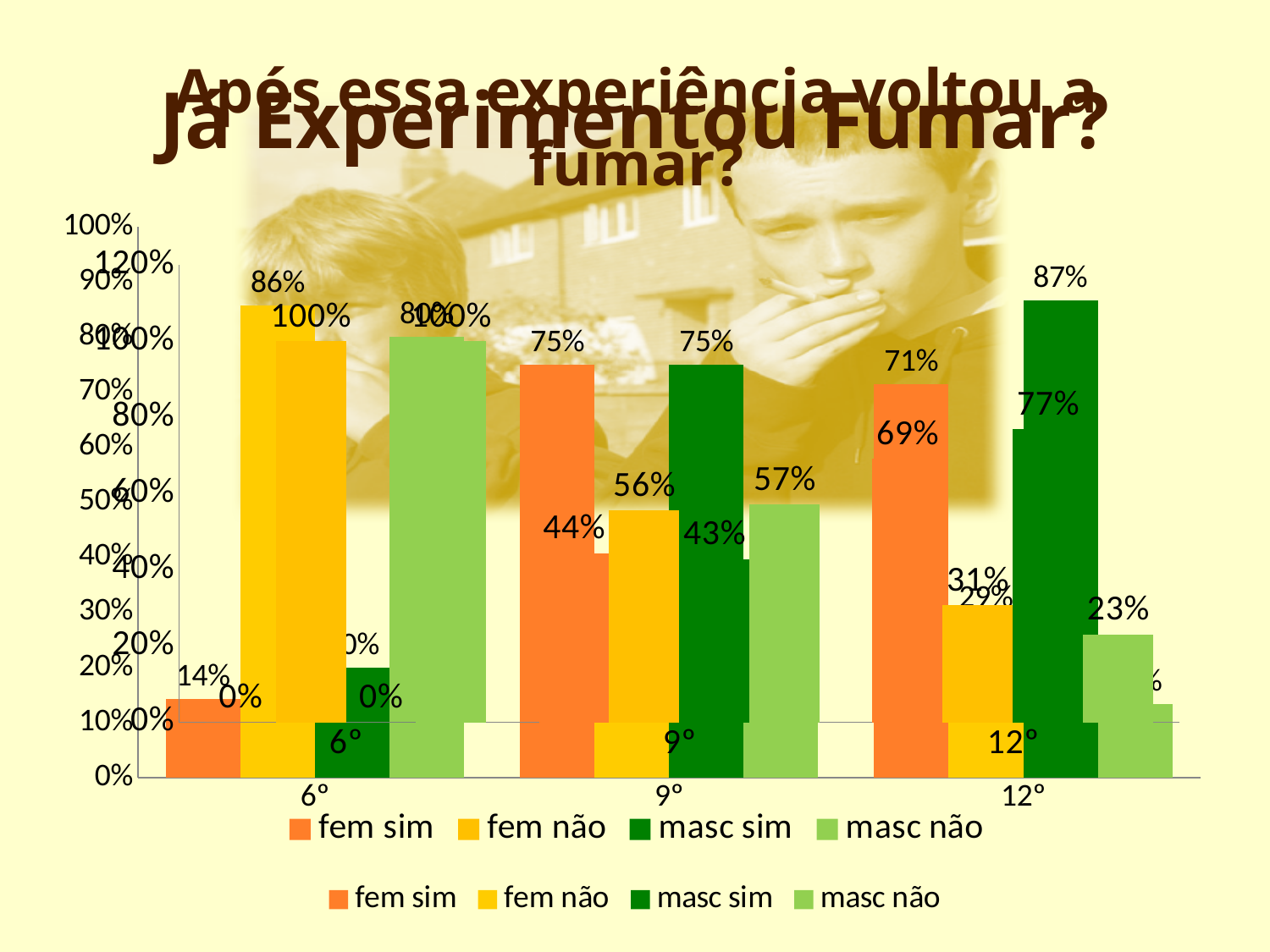
In the chart whose y axis runs from 0% to 100% in 10% steps, what is the value for masc sim at 12°? 87% In the chart whose y axis runs from 0% to 100% in 10% steps, what is the value for fem sim at 12°? 71% In the chart whose y axis runs from 0% to 100% in 10% steps, what is the value for fem sim at 6°? 14% How many series does the legend list? 4 What are the series names listed in the legend? fem sim, fem não, masc sim, masc não In the chart whose y axis runs from 0% to 100% in 10% steps, what is the value for fem não at 6°? 86% In the chart whose y axis runs from 0% to 100% in 10% steps, which series has the highest value at 12°? masc sim In the chart whose y axis runs from 0% to 100% in 10% steps, what is the difference between fem não (86%) and fem sim (14%) at 6°? 72% How many categories are shown on the x axis? 3 What are the categories on the x axis? 6°, 9°, 12° In the chart whose y axis runs from 0% to 100% in 10% steps, which is larger at 6°: fem sim or fem não? fem não What kind of chart is shown on the slide? bar chart